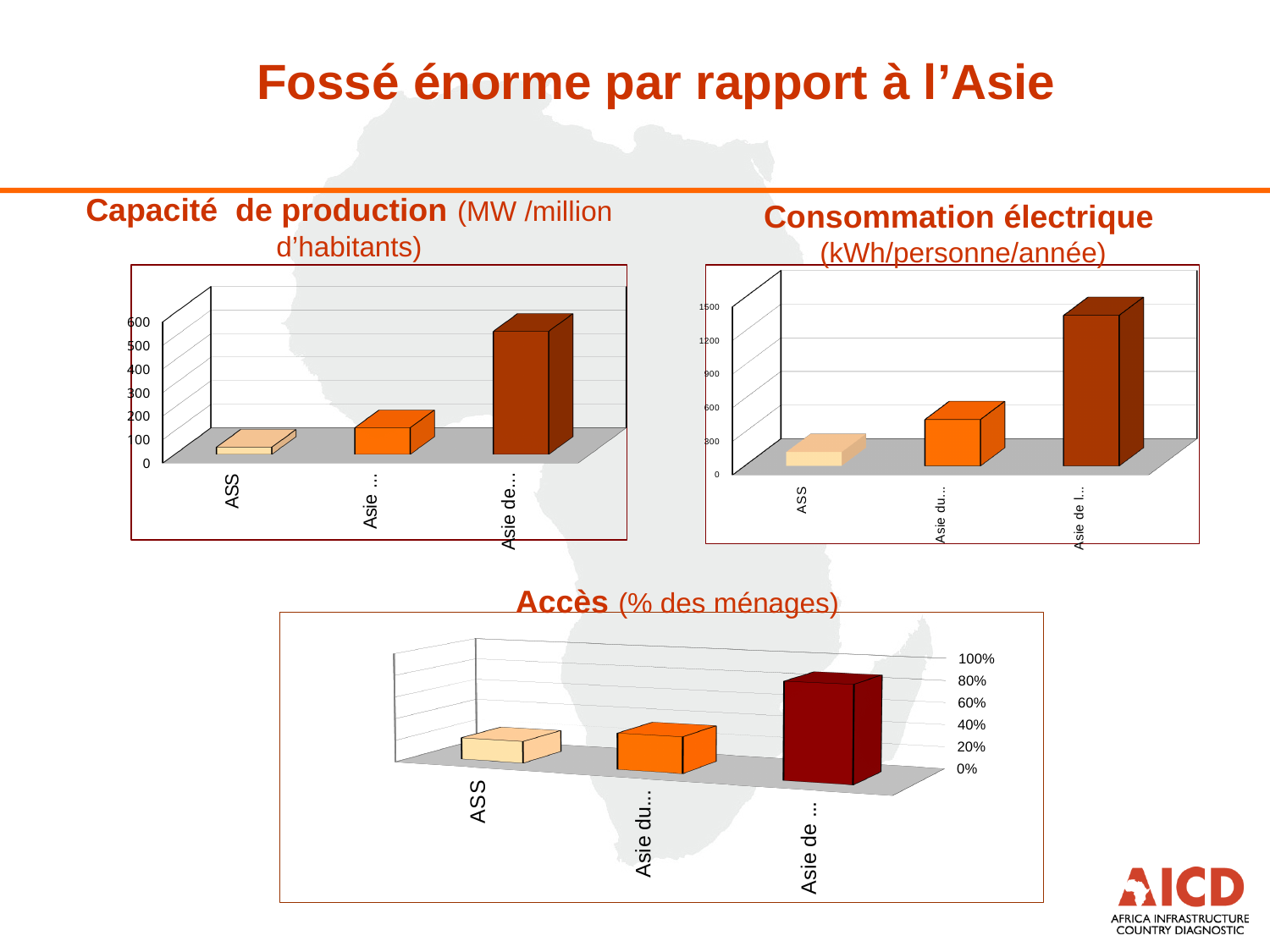
In the 'Consommation électrique' chart, which category has the lowest value? ASS In the 'Consommation électrique' chart, is the value of the rightmost bar greater or less than 900? greater In the 'Capacité de production' chart, is the value for ASS greater or less than 200? less In the 'Accès' chart, which is larger: the value for ASS or the value of the rightmost bar? the rightmost bar In the 'Capacité de production' chart, is the value of the rightmost bar greater or less than 400? greater What kind of chart is the 'Capacité de production' chart? bar chart In the 'Capacité de production' chart, which category has the lowest value? ASS How many bars does the 'Consommation électrique' chart show? 3 How many bars does the 'Accès' chart show? 3 In the 'Accès' chart, which category has the lowest value? ASS